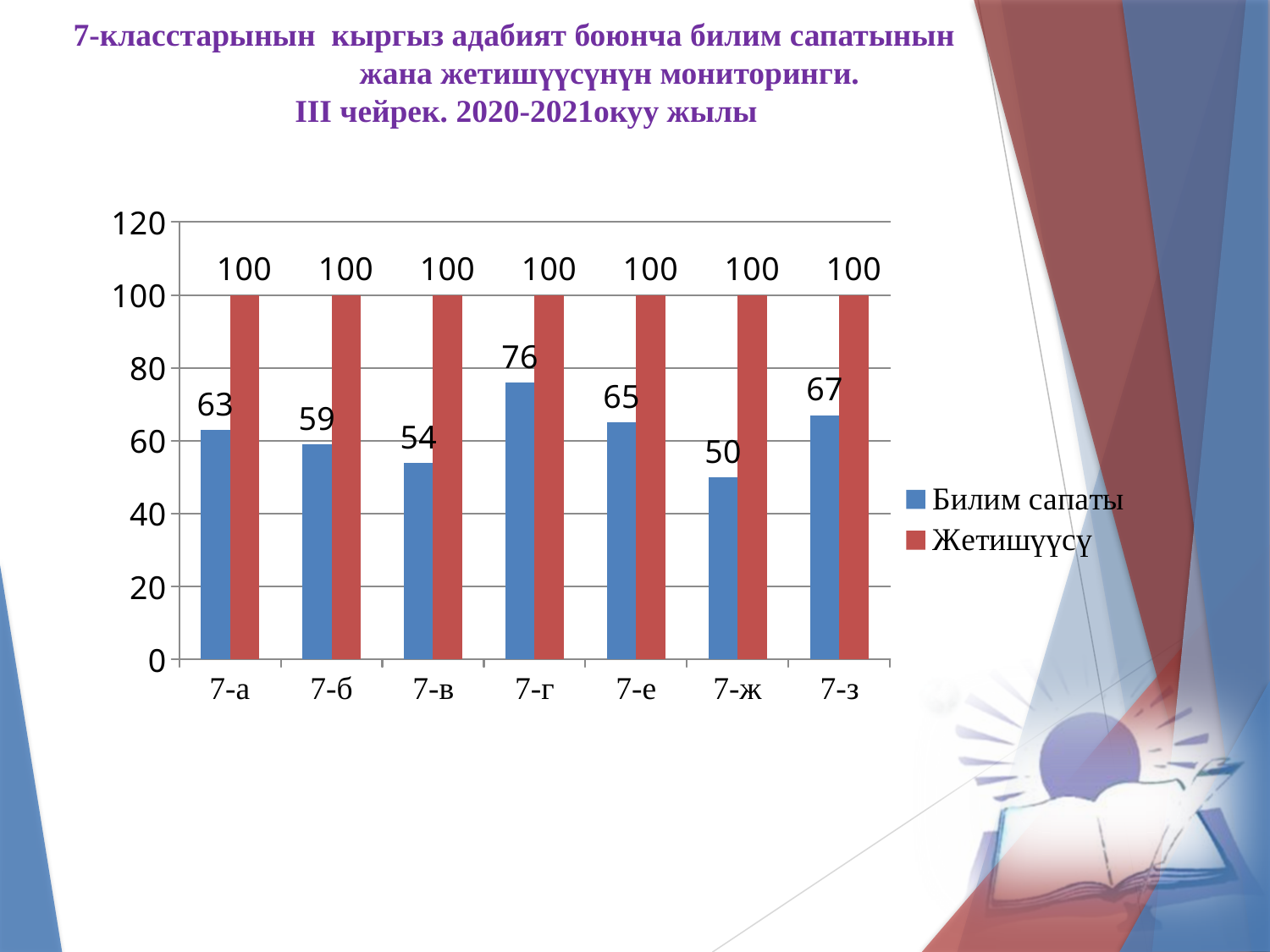
Is the Билим сапаты value for 7-в greater or less than 60? less Which class has the lowest Билим сапаты value? 7-ж Which colour represents Жетишүүсү in the chart? red What kind of chart is shown on the slide? bar chart What is the value of Жетишүүсү for 7-б? 100 What is the difference between the Билим сапаты values for 7-г and 7-ж? 26 How many classes are shown on the x axis? 7 Which has a larger Билим сапаты value, 7-а or 7-з? 7-з What is the value of Билим сапаты for 7-ж? 50 What is the value of Билим сапаты for 7-г? 76 How many series does the legend list? 2 Which class has the highest Билим сапаты value? 7-г